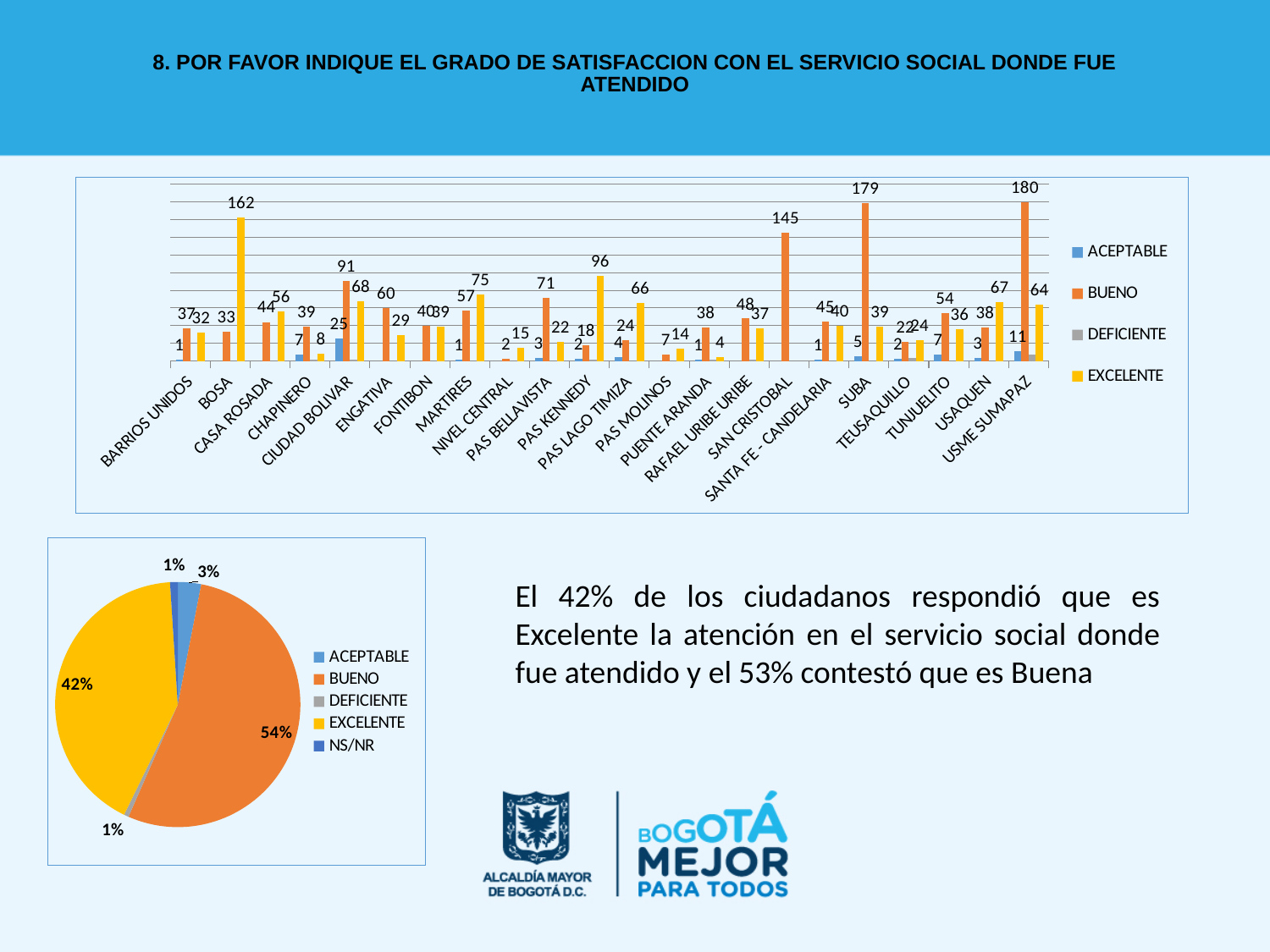
How many series does the legend of the bar chart list? 4 In the bar chart, what is the difference between the BUENO values for SUBA and CIUDAD BOLIVAR? 88 How many categories are shown on the x axis of the bar chart? 22 In the bar chart, which category has the highest BUENO value? USME SUMAPAZ In the bar chart, which category has the highest EXCELENTE value? BOSA In the pie chart, what share does BUENO have? 54% In the pie chart, what share does EXCELENTE have? 42% What kind of chart is the top chart on the slide? Bar chart In the bar chart, what is the EXCELENTE value for BOSA? 162 In the bar chart, which is larger: the EXCELENTE value for PAS KENNEDY or the EXCELENTE value for MARTIRES? PAS KENNEDY In the bar chart, what is the BUENO value for SAN CRISTOBAL? 145 How many series does the legend of the pie chart list? 5